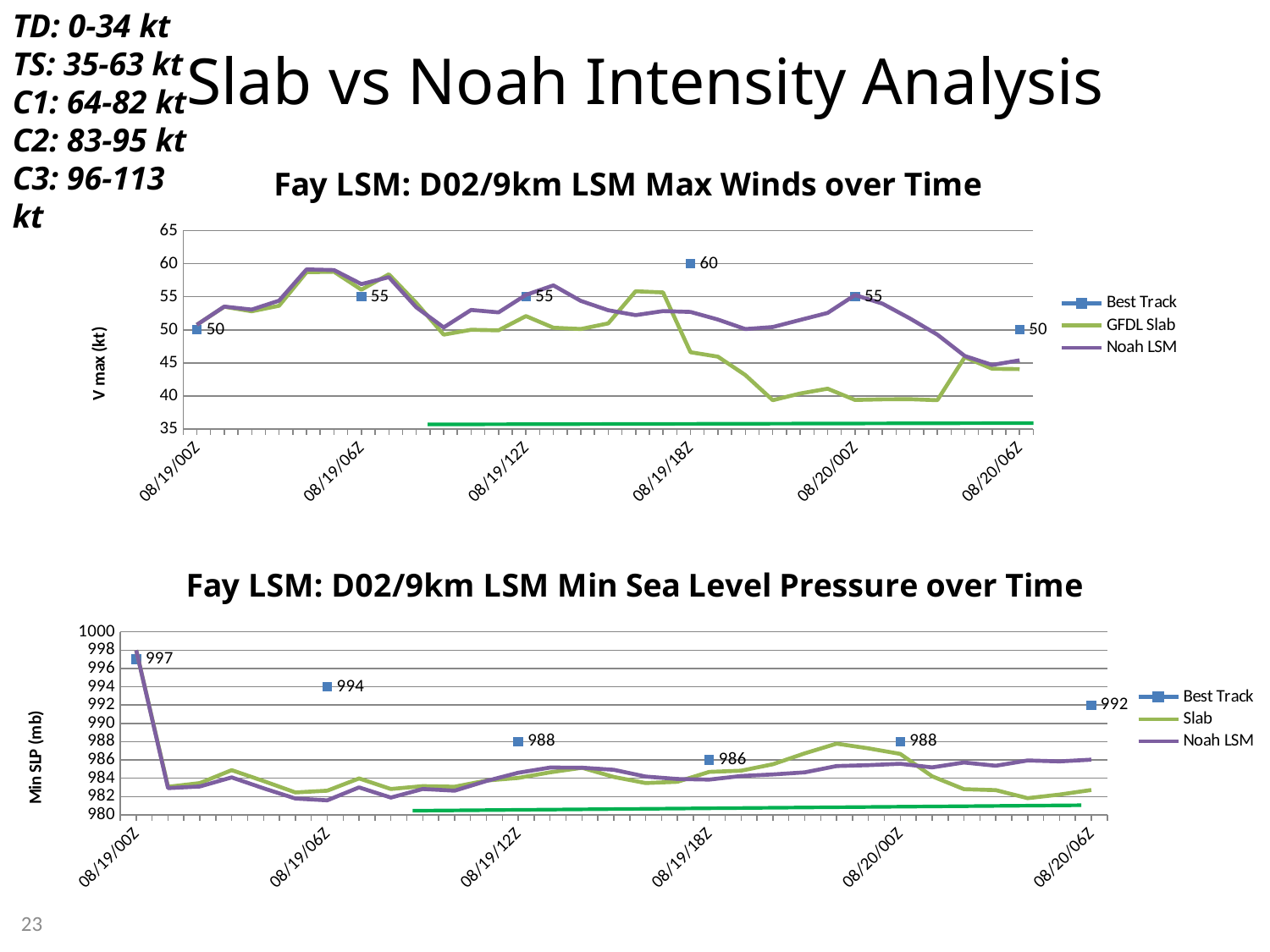
How many Best Track data points are labeled in the Min Sea Level Pressure over Time chart? 6 In the Max Winds over Time chart, what is the Best Track value at 08/19/18Z? 60 In the Min Sea Level Pressure over Time chart, what is the difference between the Best Track values at 08/19/00Z and 08/19/18Z? 11 In the Max Winds over Time chart, what is the difference between the Best Track values at 08/19/18Z and 08/20/06Z? 10 How many series does the legend of the Max Winds over Time chart list? 3 In the Min Sea Level Pressure over Time chart, which is larger: the Best Track value at 08/19/06Z or at 08/20/06Z? 08/19/06Z In the Min Sea Level Pressure over Time chart, what is the Best Track value at 08/19/00Z? 997 In the Max Winds over Time chart, what is the Best Track value at 08/19/00Z? 50 In the Max Winds over Time chart, is the GFDL Slab value at 08/20/00Z greater or less than 45? less In the Min Sea Level Pressure over Time chart, at which time is the Best Track value lowest? 08/19/18Z In the Max Winds over Time chart, at which time is the Best Track value highest? 08/19/18Z What kind of chart is the Max Winds over Time chart? Line chart